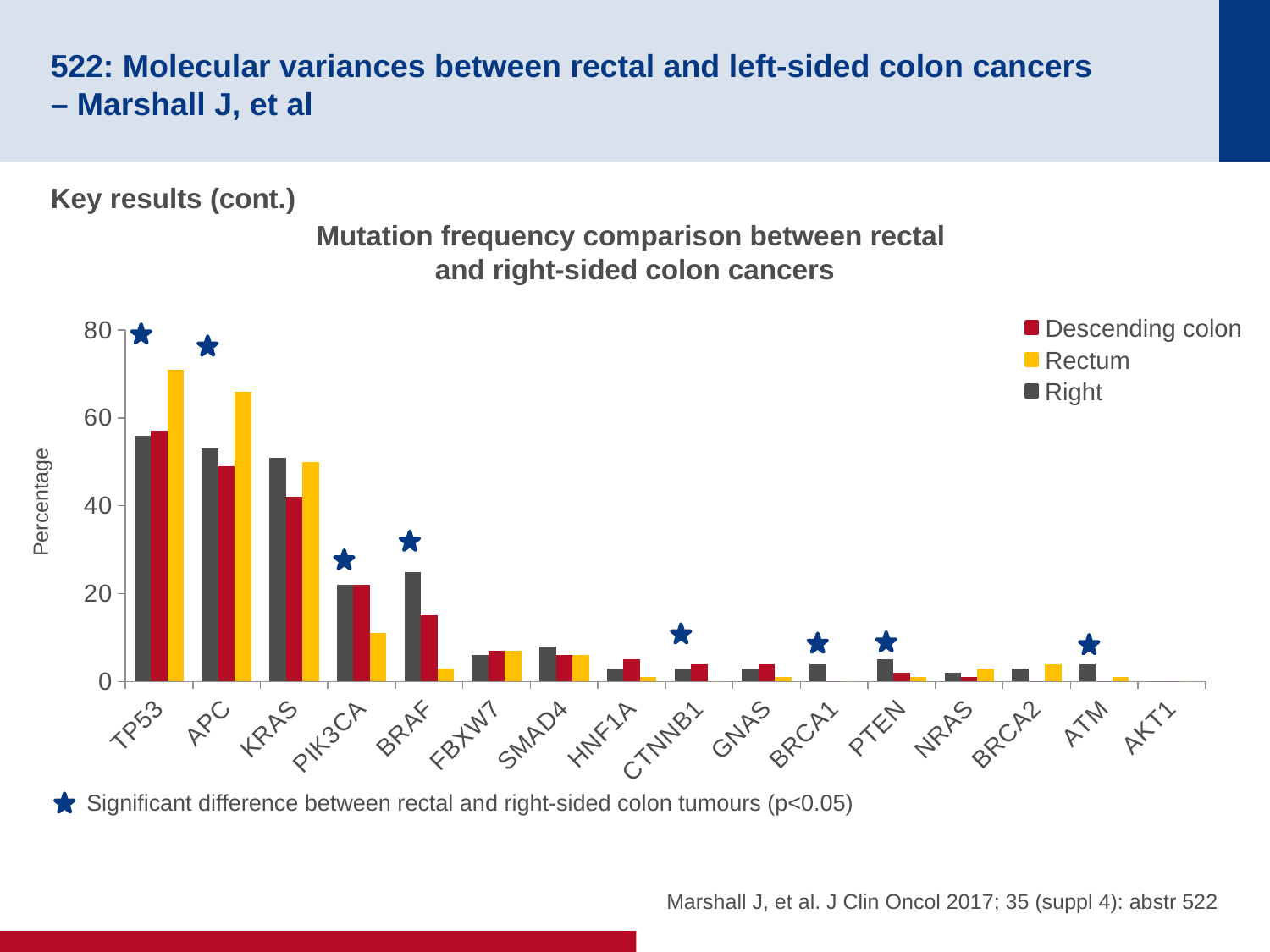
Which is larger: the Rectum value for TP53 or the Rectum value for APC? TP53 For BRAF, which series has the highest bar? Right Is the Rectum value for TP53 greater or less than 60? greater How many genes are shown along the x axis? 16 Is the Right value for BRAF greater or less than 20? greater What kind of chart is shown on the slide? Bar chart Is the Rectum value for BRAF greater or less than 20? less What is the title of the chart? Mutation frequency comparison between rectal and right-sided colon cancers How many series does the legend list? 3 Which colour represents the Rectum series in the legend? Yellow For TP53, which series has the highest bar? Rectum Which gene has the highest Rectum bar? TP53